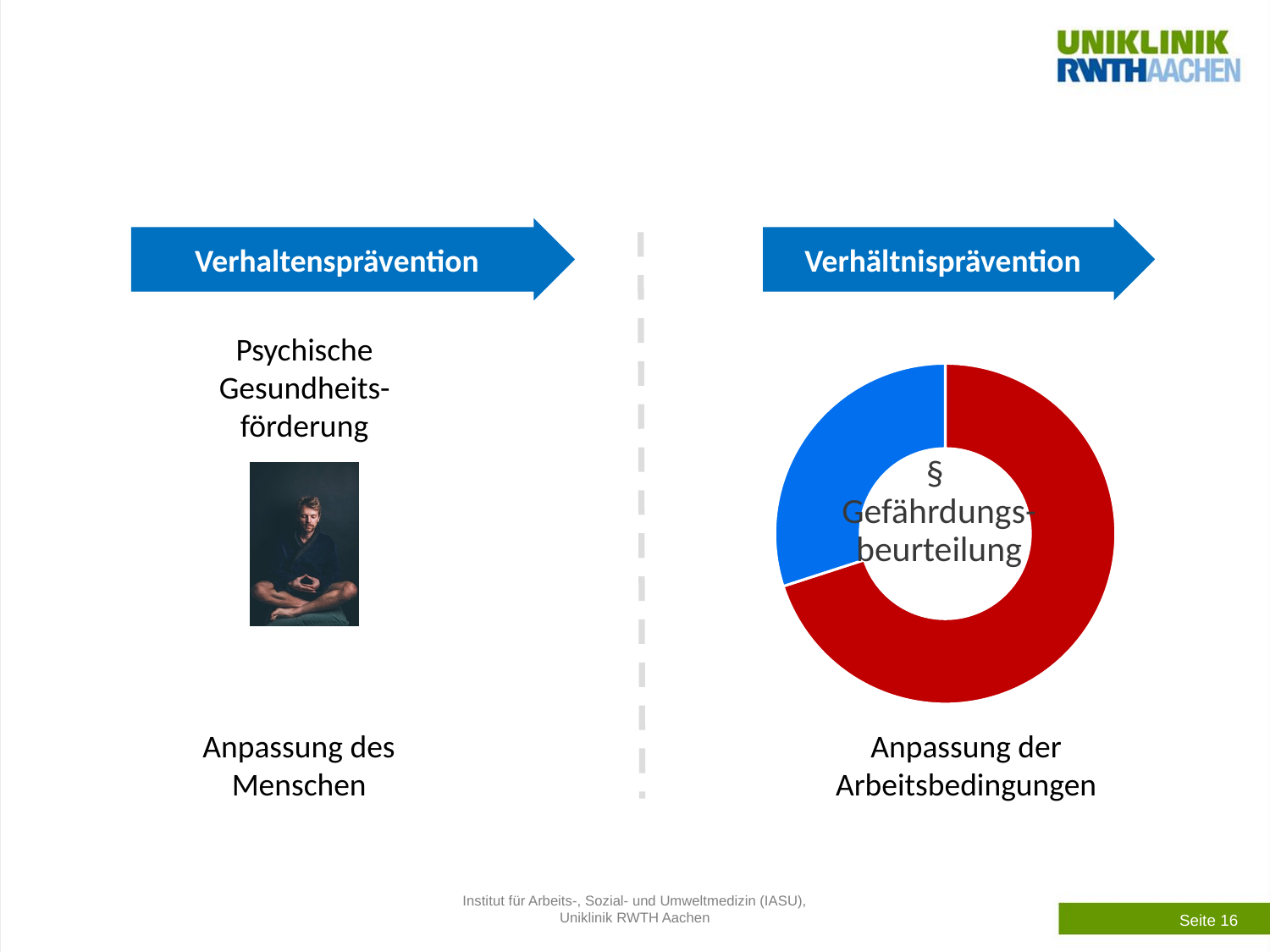
How many slices does the doughnut chart on the slide have? 2 What two colours are used for the slices of the doughnut chart? red and blue Which colour slice takes up the largest share of the doughnut chart? red Which slice of the doughnut chart is larger, the red one or the blue one? red Which colour slice takes up the smallest share of the doughnut chart? blue What text is written in the centre of the doughnut chart? § Gefährdungs-beurteilung What kind of chart is shown on the right side of the slide under "Verhältnisprävention"? doughnut chart